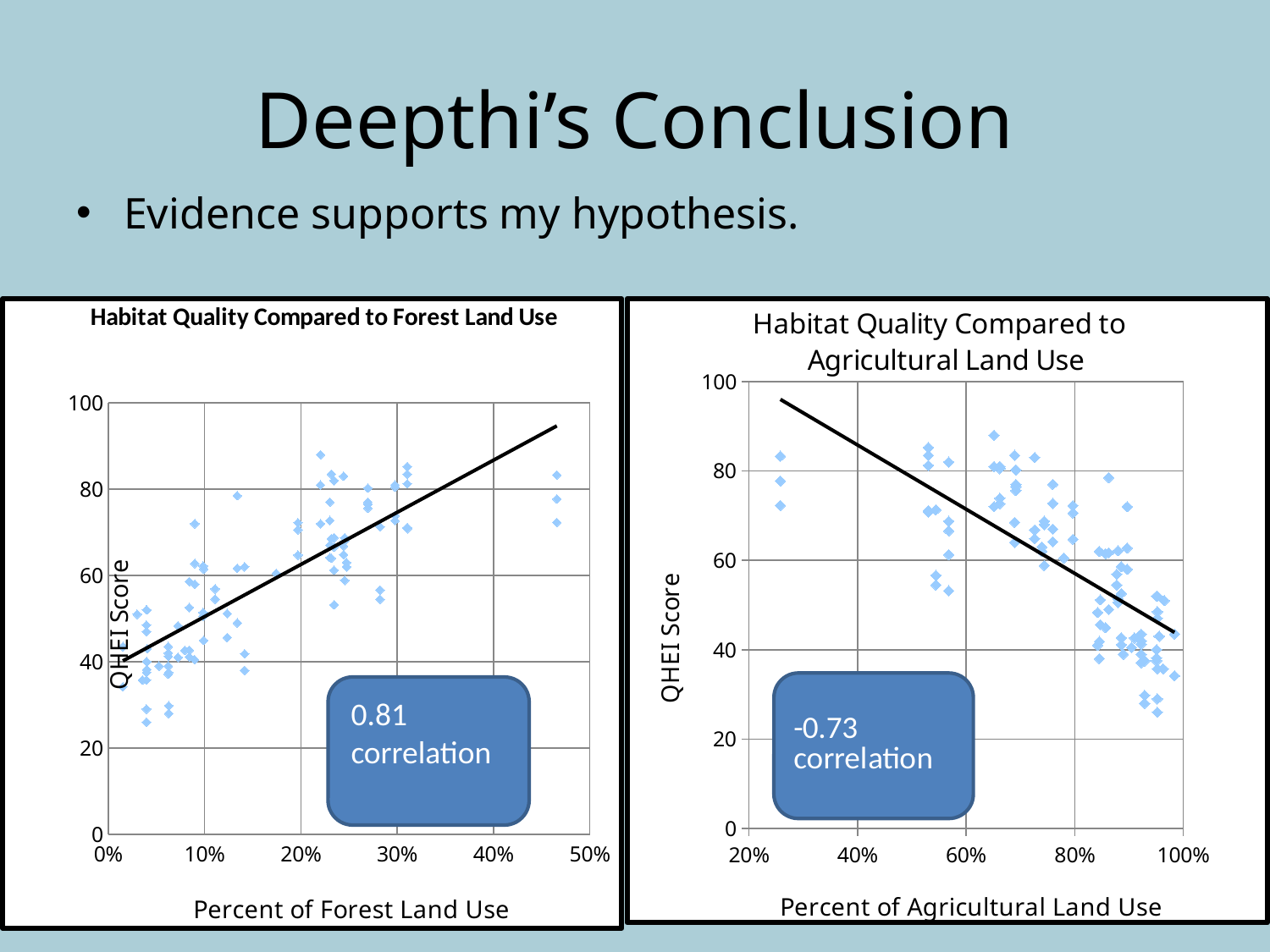
In the 'Habitat Quality Compared to Agricultural Land Use' chart, are the QHEI scores for the points at about 25% agricultural land use greater or less than 60? greater What kind of chart is the 'Habitat Quality Compared to Agricultural Land Use' chart on the right? Scatter chart What correlation value is shown on the 'Habitat Quality Compared to Agricultural Land Use' chart? -0.73 In the 'Habitat Quality Compared to Forest Land Use' chart, do QHEI scores generally rise or fall as percent of forest land use increases? Rise What kind of chart is the 'Habitat Quality Compared to Forest Land Use' chart on the left? Scatter chart In the 'Habitat Quality Compared to Forest Land Use' chart, are the lowest points near 3% forest land use greater or less than 40? less What correlation value is shown on the 'Habitat Quality Compared to Forest Land Use' chart? 0.81 In the 'Habitat Quality Compared to Agricultural Land Use' chart, are the QHEI scores for the points near 98% agricultural land use greater or less than 60? less In the 'Habitat Quality Compared to Agricultural Land Use' chart, do QHEI scores generally rise or fall as percent of agricultural land use increases? Fall